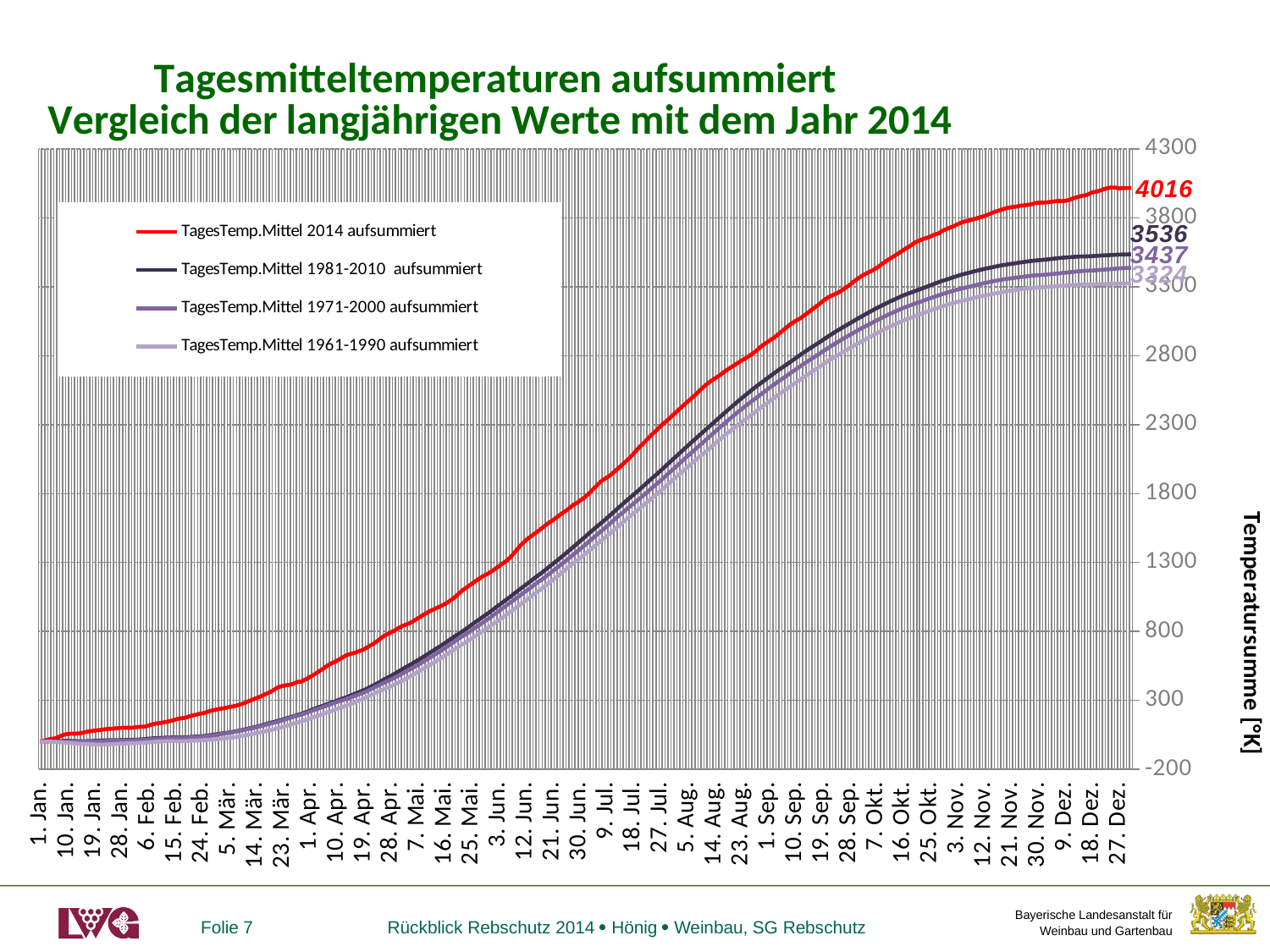
What is the final labelled value of the series 'TagesTemp.Mittel 1971-2000 aufsummiert'? 3437 How many series does the legend list? 4 What kind of chart is shown on the slide? line chart What is the difference between the final values of the 1981-2010 series and the 1971-2000 series? 99 Which series reaches the lowest value at the end of the year? TagesTemp.Mittel 1961-1990 aufsummiert What is the final labelled value of the series 'TagesTemp.Mittel 2014 aufsummiert'? 4016 What is the difference between the final values of the 2014 series and the 1981-2010 series? 480 Is the value of the 2014 series at 1. Sep. greater or less than 2300? greater Do the plotted values rise or fall along the x axis from January to December? rise Which series reaches the highest value at the end of the year? TagesTemp.Mittel 2014 aufsummiert What is the final labelled value of the series 'TagesTemp.Mittel 1981-2010 aufsummiert'? 3536 What is the title of the vertical axis? Temperatursumme [°K]